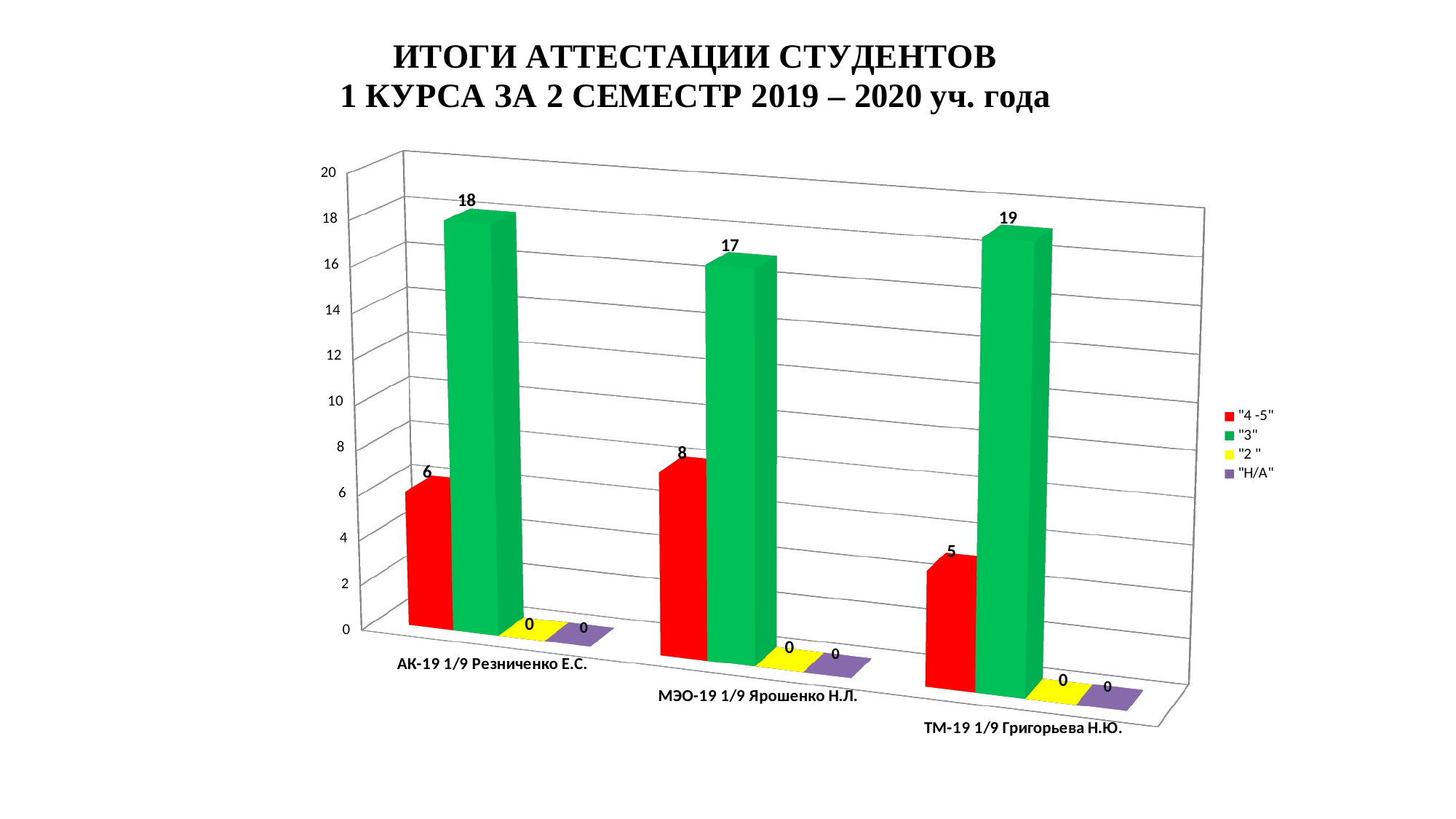
What is the value of the "4 -5" series for ТМ-19 1/9 Григорьева Н.Ю.? 5 How many series does the legend list? 4 What kind of chart is shown on the slide? Bar chart What is the value of the "3" series for АК-19 1/9 Резниченко Е.С.? 18 How many groups (categories) are shown on the x axis? 3 Which is larger: the "3" value for МЭО-19 1/9 Ярошенко Н.Л. or the "3" value for ТМ-19 1/9 Григорьева Н.Ю.? ТМ-19 1/9 Григорьева Н.Ю. What is the value of the "4 -5" series for МЭО-19 1/9 Ярошенко Н.Л.? 8 What is the value of the "2 " series for МЭО-19 1/9 Ярошенко Н.Л.? 0 Which group has the highest value in the "3" series? ТМ-19 1/9 Григорьева Н.Ю. What is the difference between the "3" value and the "4 -5" value for АК-19 1/9 Резниченко Е.С.? 12 What colour represents the "Н/А" series in the legend? Purple Which group has the lowest value in the "4 -5" series? ТМ-19 1/9 Григорьева Н.Ю.